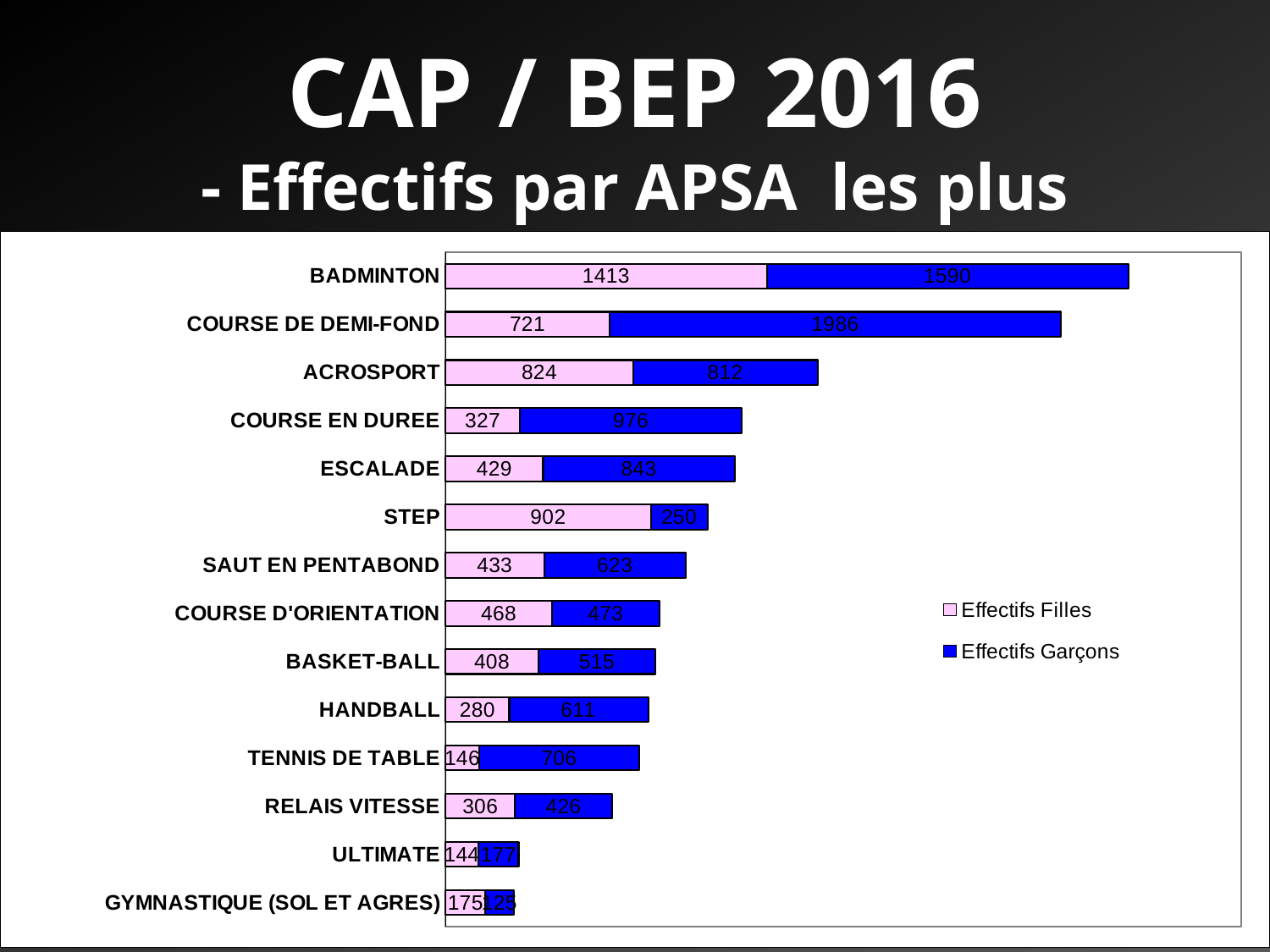
What is the value of Effectifs Garçons for COURSE DE DEMI-FOND? 1986 What is the total of the stacked bar for BADMINTON? 3003 How many APSA categories are shown on the chart? 14 For STEP, which is larger: Effectifs Filles or Effectifs Garçons? Effectifs Filles Which category has the highest value for Effectifs Filles? BADMINTON Which category has the highest value for Effectifs Garçons? COURSE DE DEMI-FOND Which legend entry is shown in pink? Effectifs Filles What is the value of Effectifs Filles for BADMINTON? 1413 What is the value of Effectifs Garçons for STEP? 250 What kind of chart is shown on the slide? Stacked horizontal bar chart How many series does the legend list? 2 What is the difference between Effectifs Garçons and Effectifs Filles for COURSE DE DEMI-FOND? 1265